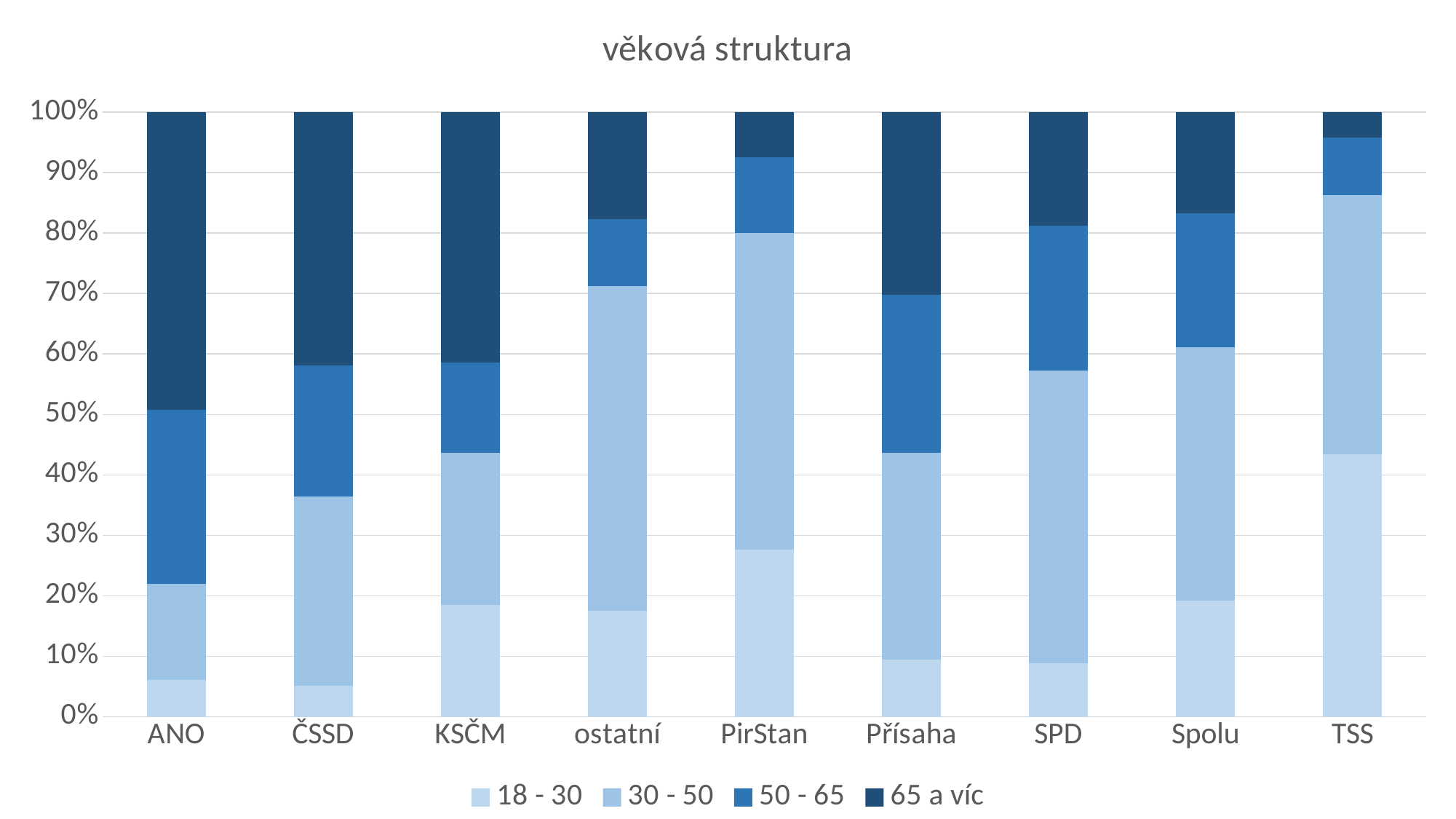
Is the "18 - 30" value for ANO greater or less than 10%? less Which category has the smallest "65 a víc" segment? TSS Which is larger, the "65 a víc" segment for ANO or for TSS? ANO How many categories are shown on the x axis? 9 What is the total of the stacked bar for ANO? 100% What kind of chart is shown on the slide? bar chart Is the "18 - 30" value for TSS greater or less than 40%? greater Which category has the largest "18 - 30" segment? TSS Which category has the largest "65 a víc" segment? ANO What is the title of the chart? věková struktura How many series does the legend list? 4